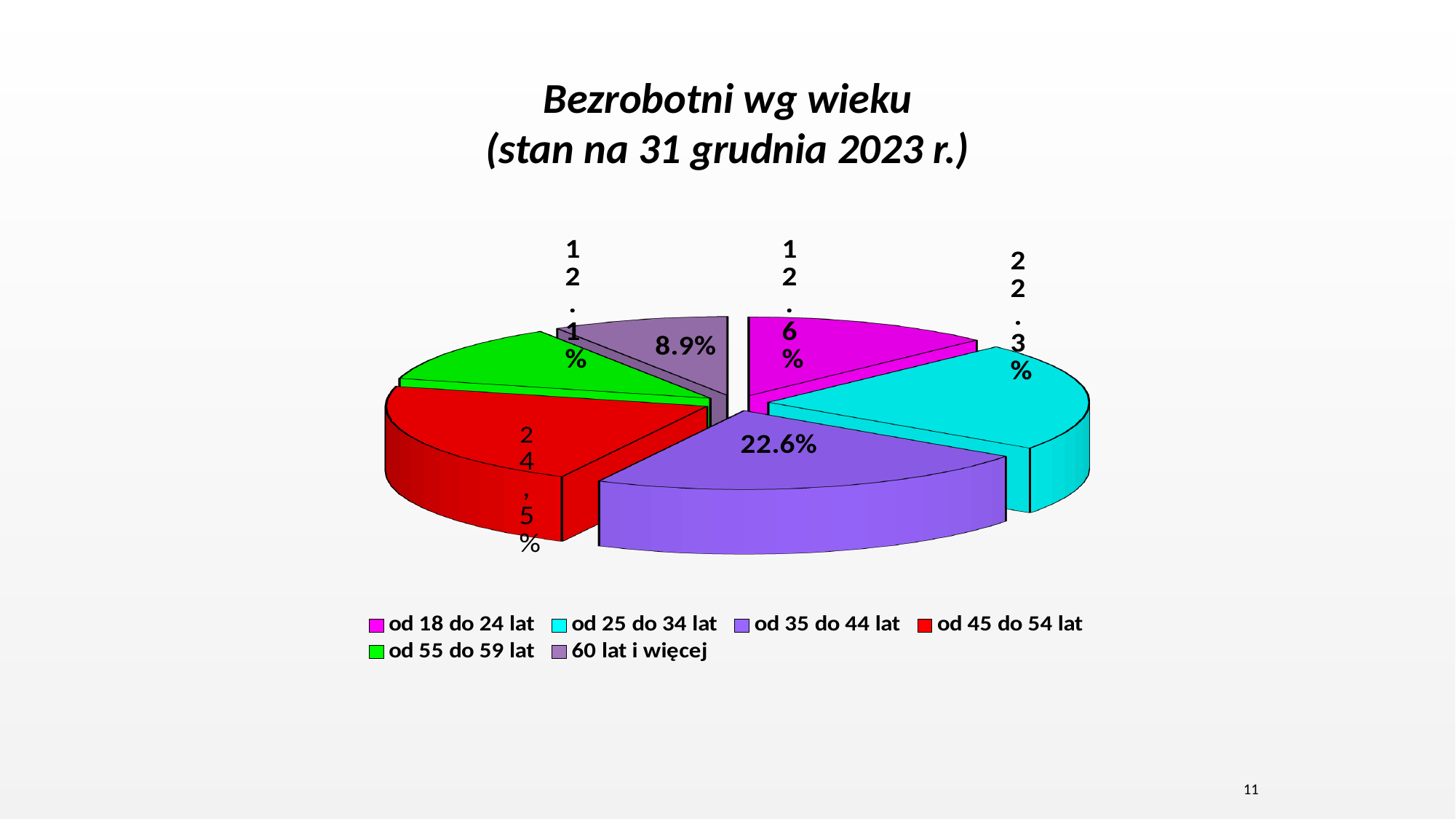
What share of the pie is the slice for 'od 35 do 44 lat'? 22.6% What share of the pie is the slice for '60 lat i więcej'? 8.9% What share of the pie is the slice for 'od 45 do 54 lat'? 24,5% What share of the pie is the slice for 'od 18 do 24 lat'? 12.6% How many age categories does the pie chart show? 6 What kind of chart is shown on the slide? pie chart What share of the pie is the slice for 'od 55 do 59 lat'? 12.1% What is the title of the chart? Bezrobotni wg wieku (stan na 31 grudnia 2023 r.) What is the difference in percentage points between the 'od 35 do 44 lat' slice and the '60 lat i więcej' slice? 13.7% Which slice is larger: 'od 45 do 54 lat' or 'od 18 do 24 lat'? od 45 do 54 lat Which age category has the smallest slice of the pie? 60 lat i więcej